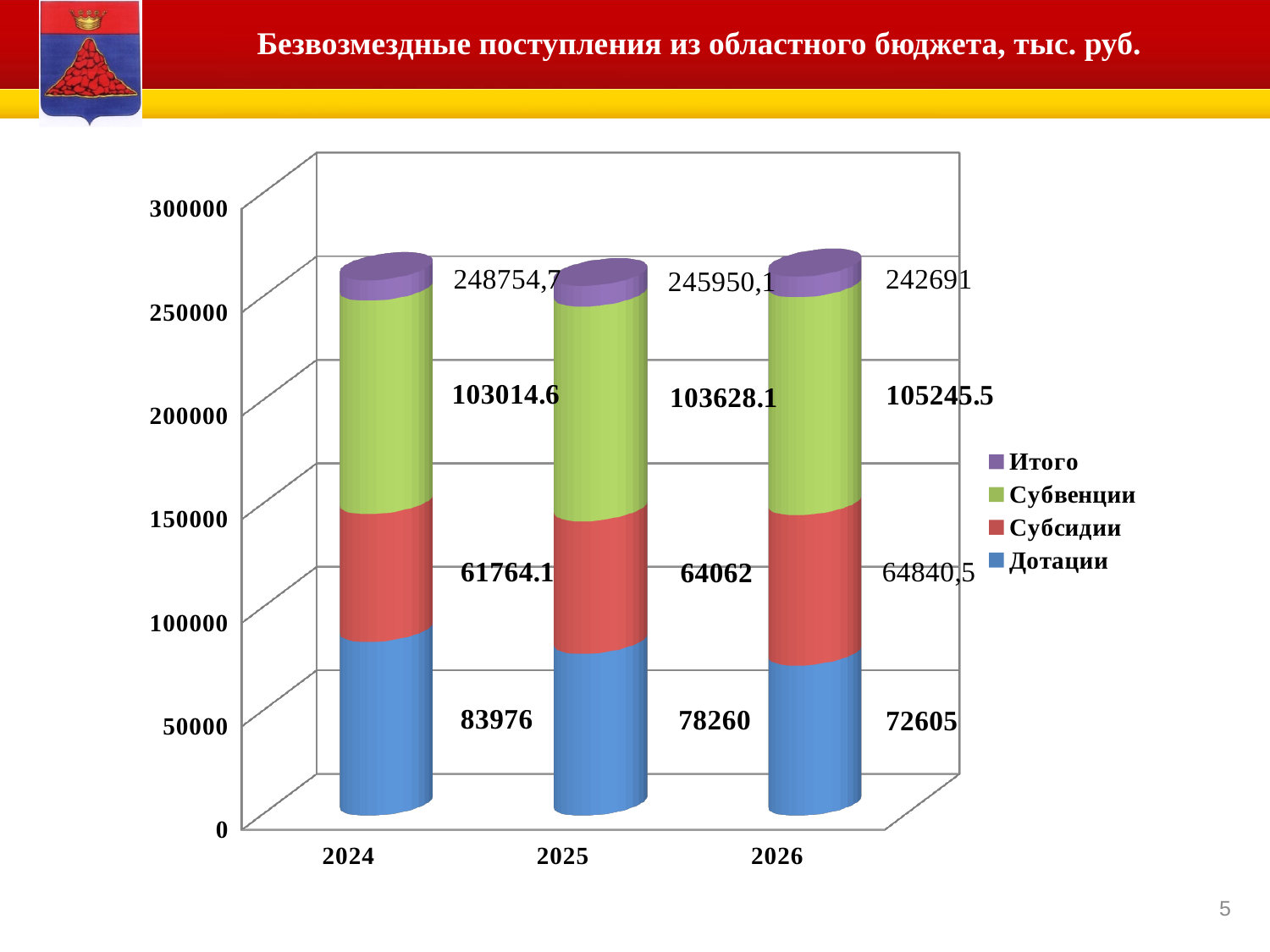
What is the Итого value shown for 2026? 242691 What is the difference between the Дотации values for 2024 and 2026? 11371 What kind of chart is shown on the slide? Stacked bar chart How do the Дотации values change from 2024 to 2026? They fall In which year is the value for Дотации the highest? 2024 How many years are shown on the x axis? 3 What is the value for Субсидии in 2026? 64840,5 What is the value for Субвенции in 2025? 103628.1 Which is larger, the Субсидии value for 2025 or for 2024? 2025 What is the value for Дотации in 2024? 83976 In which year is the value for Субвенции the lowest? 2024 How many series does the legend list? 4